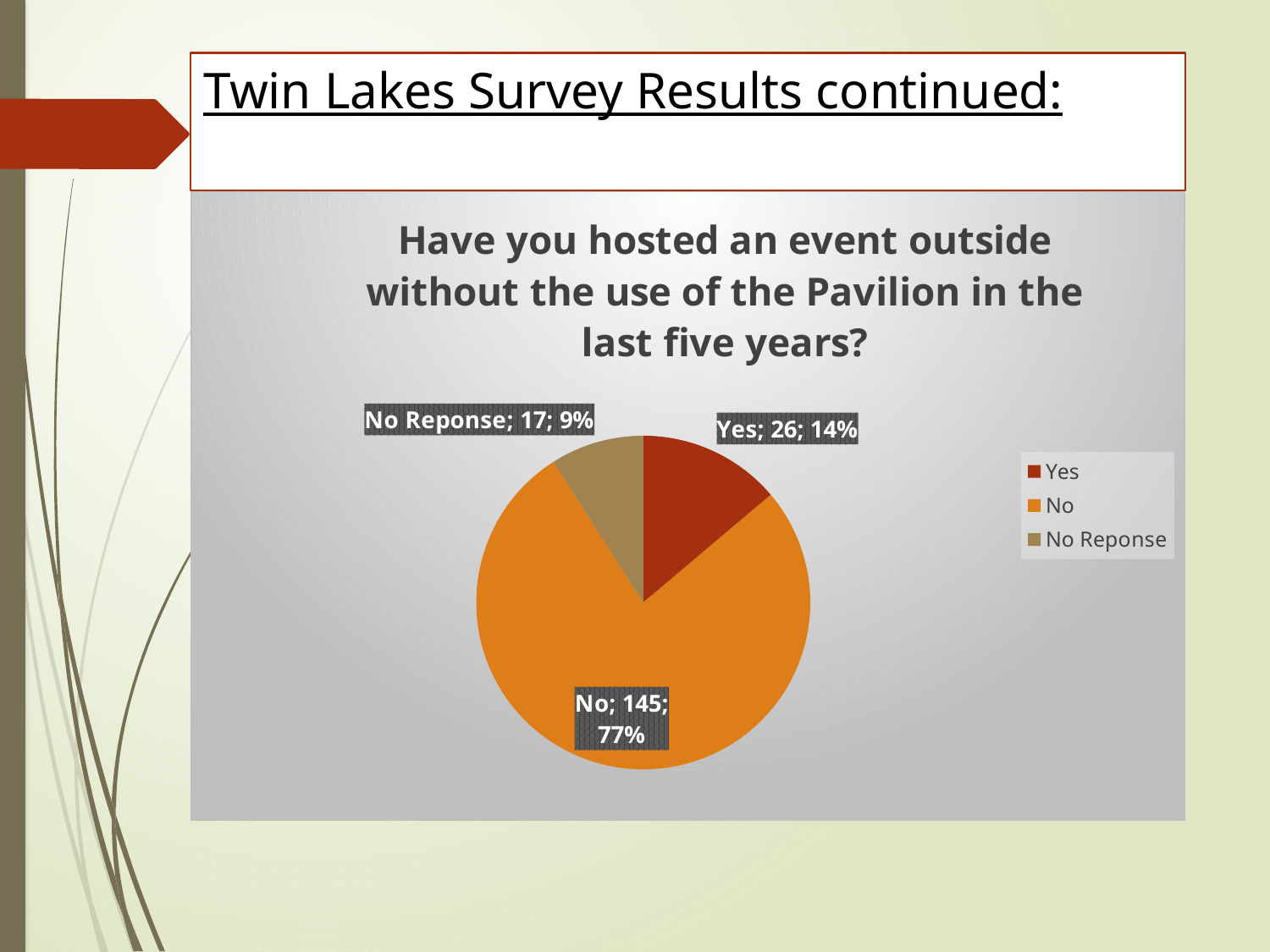
How many respondents answered "No"? 145 What percentage share of the pie does the "No" slice represent? 77% What percentage share of the pie does the "Yes" slice represent? 14% How many respondents answered "Yes"? 26 Which category has the largest slice of the pie? No Which is larger, the count for "Yes" or the count for "No Reponse"? Yes What kind of chart is shown on the slide? pie chart What is the difference between the number of "No" responses and the number of "Yes" responses? 119 What percentage share of the pie does the "No Reponse" slice represent? 9% How many categories does the legend list? 3 How many respondents gave no response? 17 Which category has the smallest slice of the pie? No Reponse